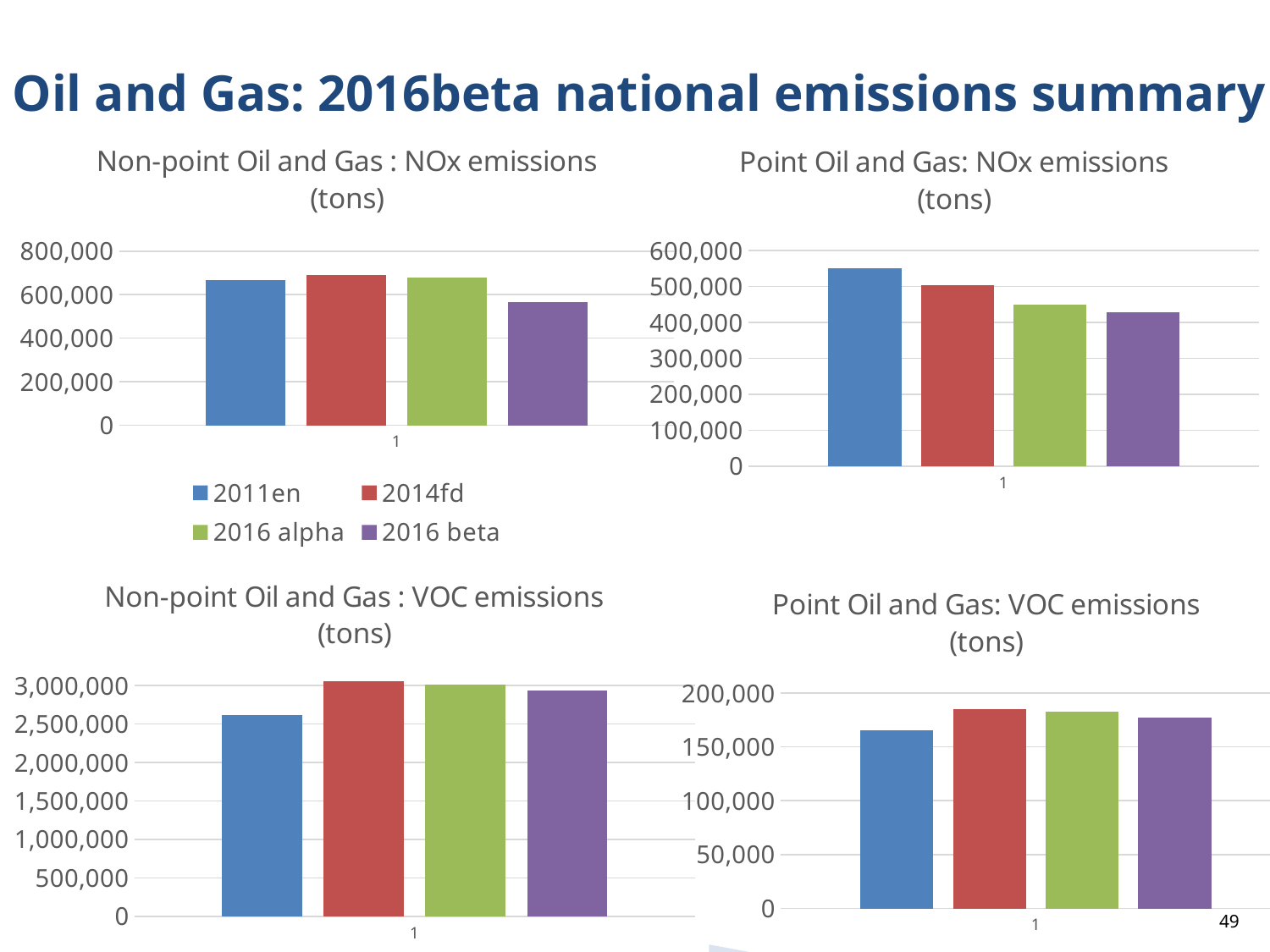
On the Point Oil and Gas: VOC emissions chart, which is larger, the value for 2011en or the value for 2014fd? 2014fd On the Non-point Oil and Gas : VOC emissions chart, is the value for 2011en greater or less than 2,500,000? greater How many series does the legend list on the Non-point Oil and Gas : NOx emissions chart? 4 On the Point Oil and Gas: NOx emissions chart, is the value for 2016 beta greater or less than 500,000? less On the Non-point Oil and Gas : VOC emissions chart, which series has the lowest value? 2011en On the Non-point Oil and Gas : NOx emissions chart, is the value for 2016 beta greater or less than 600,000? less On the Point Oil and Gas: NOx emissions chart, do the values rise or fall from left to right? fall On the Non-point Oil and Gas : NOx emissions chart, which series has the lowest value? 2016 beta What kind of chart is the Point Oil and Gas: NOx emissions chart? bar chart How many bars are plotted on the Point Oil and Gas: VOC emissions chart? 4 On the Point Oil and Gas: NOx emissions chart, which series has the highest value? 2011en